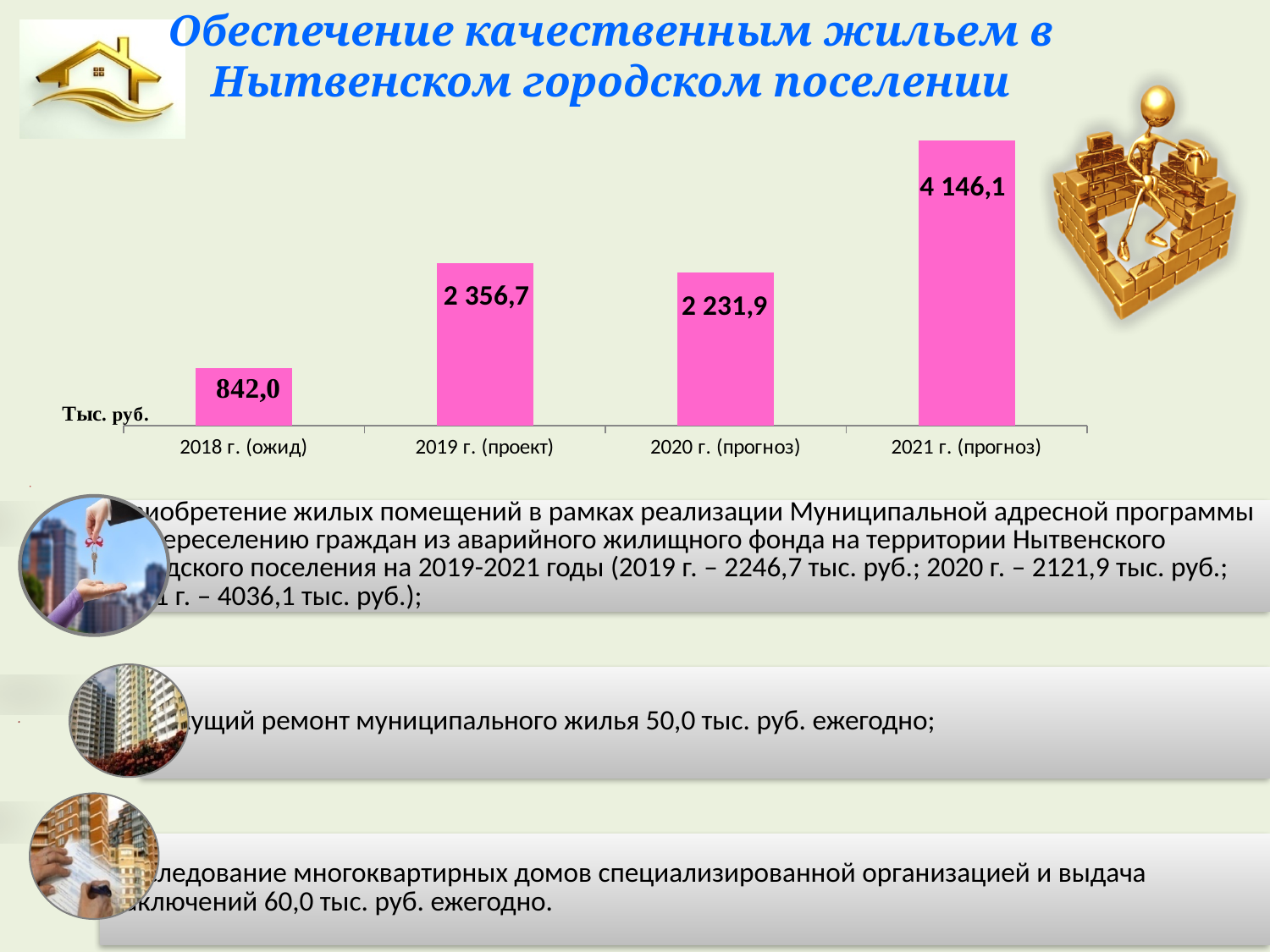
How many categories are shown on the x axis? 4 What kind of chart is shown on the slide? bar chart What unit label is shown next to the chart's axis? Тыс. руб. What is the value for 2019 г. (проект)? 2 356,7 What is the difference between the values for 2019 г. (проект) and 2020 г. (прогноз)? 124,8 Which category has the lowest value? 2018 г. (ожид) What is the value for 2021 г. (прогноз)? 4 146,1 What is the value for 2020 г. (прогноз)? 2 231,9 Which is larger, the value for 2019 г. (проект) or 2020 г. (прогноз)? 2019 г. (проект) What is the value for 2018 г. (ожид)? 842,0 What is the difference between the values for 2021 г. (прогноз) and 2018 г. (ожид)? 3 304,1 Which category has the highest value? 2021 г. (прогноз)